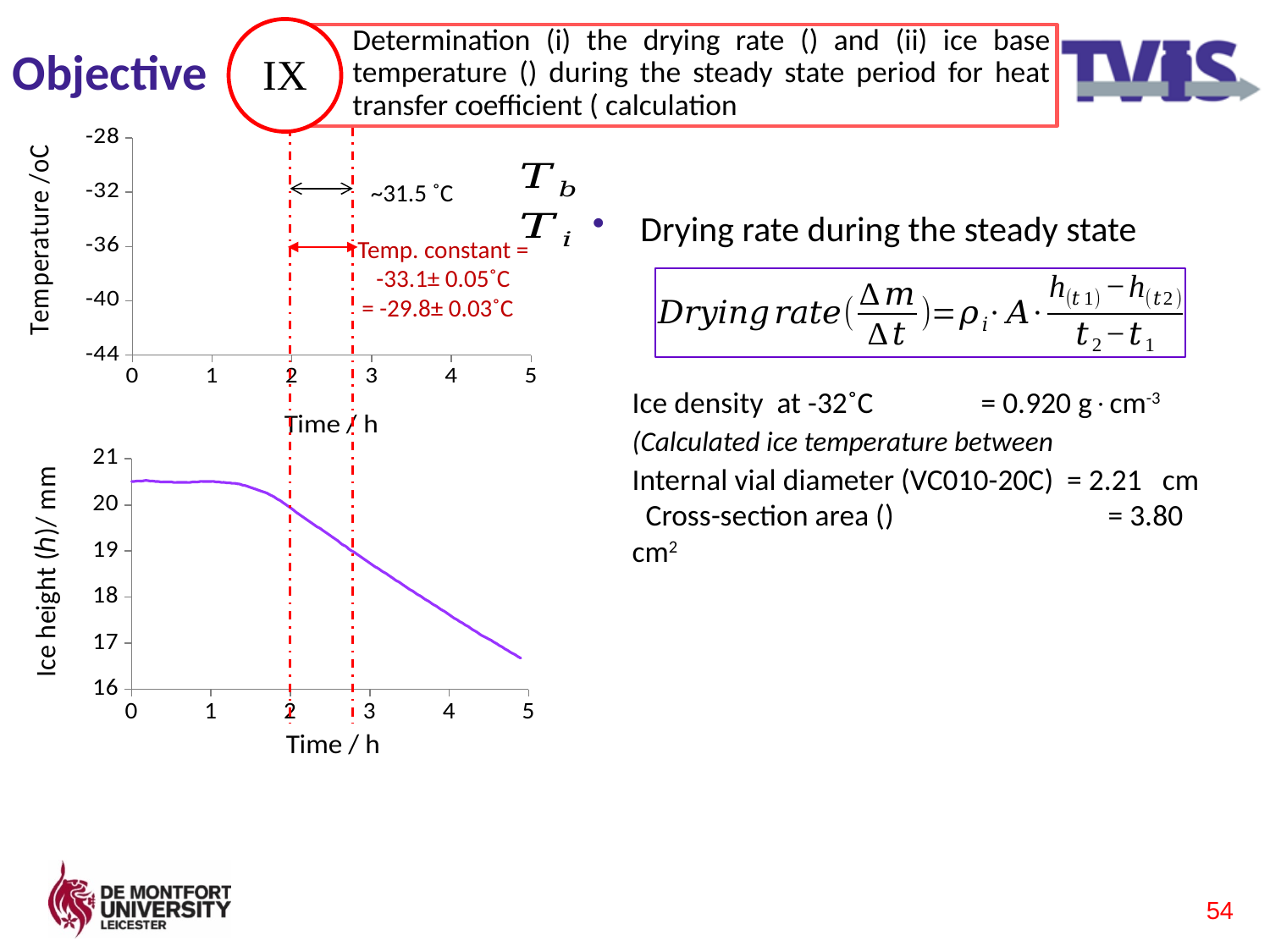
In the bottom chart, what is the label of the y axis? Ice height (h)/ mm In the bottom chart (Ice height vs Time), is the ice height at time 1 h greater or less than 20 mm? greater In the bottom chart (Ice height vs Time), is the ice height at time 3.5 h greater or less than 19 mm? less In the bottom chart (Ice height vs Time), does the ice height rise or fall as time increases from 2 h to 5 h? fall What kind of chart is the bottom chart (Ice height vs Time)? line chart In the bottom chart (Ice height vs Time), is the ice height at time 0 h greater or less than 20 mm? greater In the top chart (Temperature vs Time), what is the label of the x axis? Time / h In the top chart (Temperature vs Time), what is the highest value shown on the y axis? -28 In the top chart (Temperature vs Time), what is the lowest value shown on the y axis? -44 In the bottom chart (Ice height vs Time), what is the highest value shown on the x axis? 5 In the bottom chart (Ice height vs Time), which is larger: the ice height at 1 h or the ice height at 4 h? the ice height at 1 h